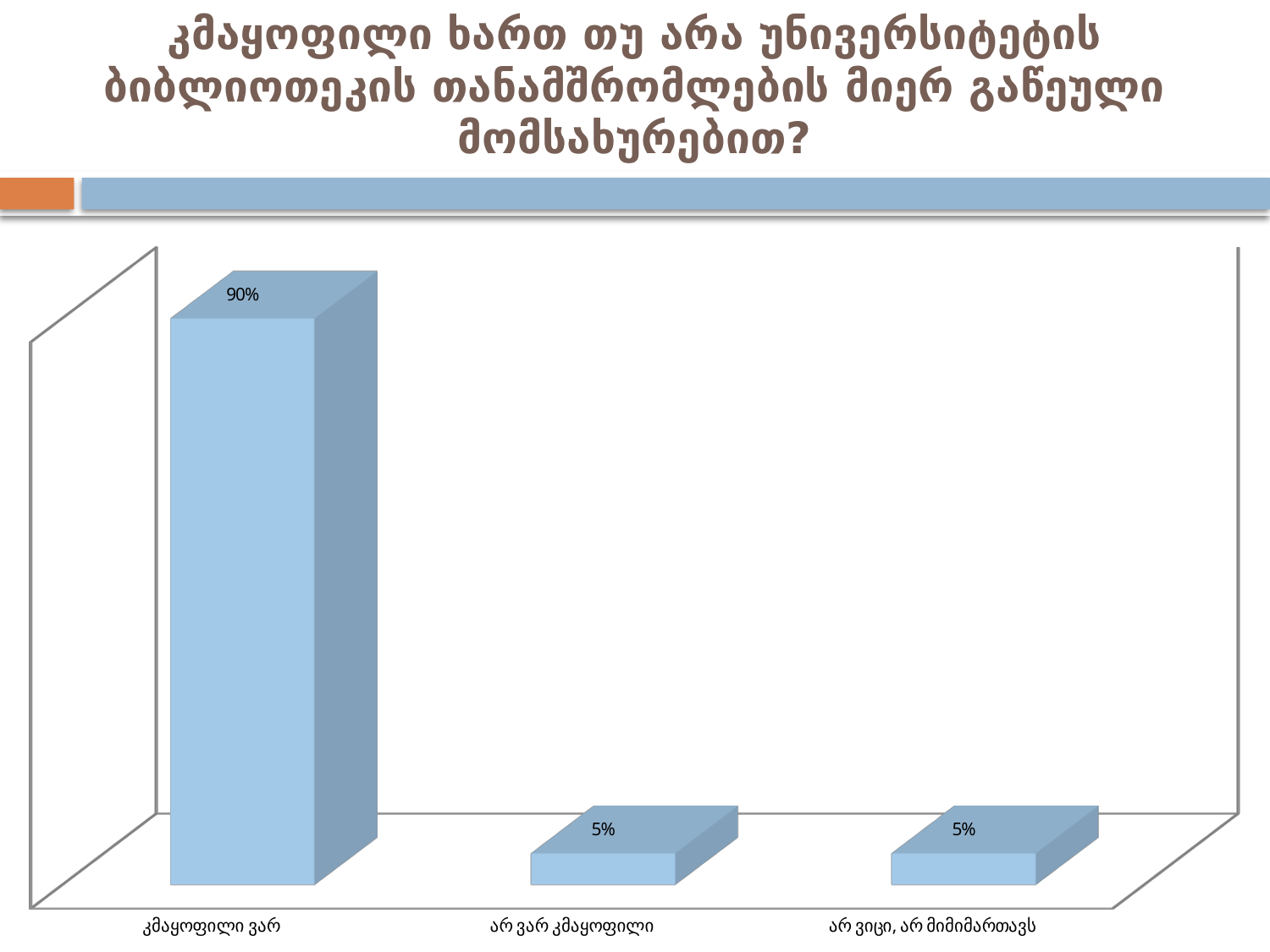
What is the value for "არ ვიცი, არ მიმიმართავს"? 5% What kind of chart is shown on the slide? Bar chart How many categories have a value of 5%? 2 How many categories are shown in the chart? 3 What is the value for "კმაყოფილი ვარ"? 90% Which category has the highest value? კმაყოფილი ვარ What is the difference between the values for "კმაყოფილი ვარ" and "არ ვარ კმაყოფილი"? 85% What is the title of the slide? კმაყოფილი ხართ თუ არა უნივერსიტეტის ბიბლიოთეკის თანამშრომლების მიერ გაწეული მომსახურებით? Which is larger, the value for "კმაყოფილი ვარ" or the value for "არ ვიცი, არ მიმიმართავს"? კმაყოფილი ვარ What colour are the bars in the chart? Light blue What is the total of all three values shown in the chart? 100% What is the value for "არ ვარ კმაყოფილი"? 5%